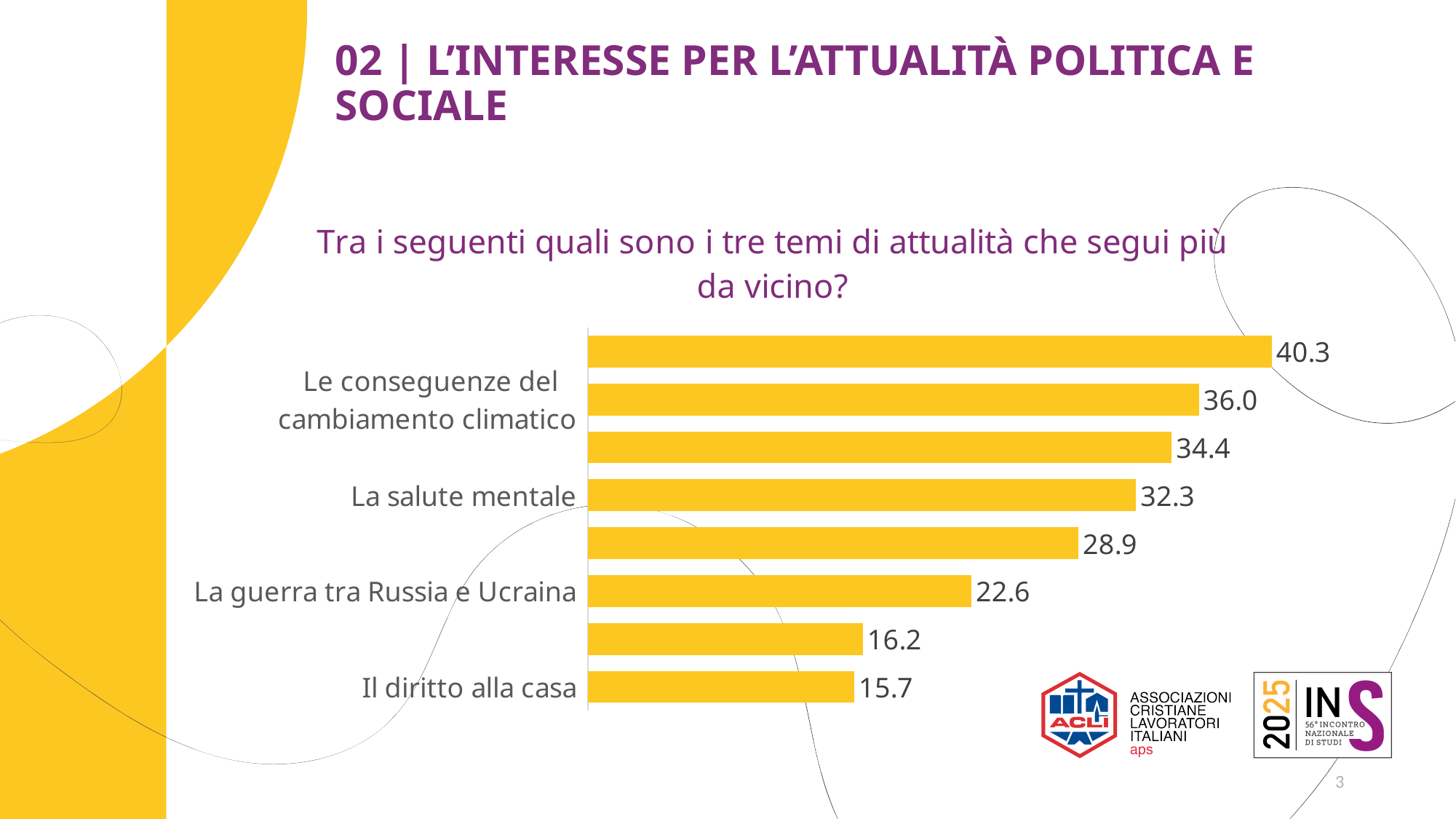
What is the difference between the values for "Le conseguenze del cambiamento climatico" and "Il diritto alla casa"? 20.3 What value is shown for "La guerra tra Russia e Ucraina"? 22.6 What is the difference between the values for "La salute mentale" and "La guerra tra Russia e Ucraina"? 9.7 What value is shown for "La salute mentale"? 32.3 What is the highest value shown on the chart? 40.3 What value is shown for "Il diritto alla casa"? 15.7 Which has a larger value, "La salute mentale" or "La guerra tra Russia e Ucraina"? La salute mentale What value is shown for "Le conseguenze del cambiamento climatico"? 36.0 Which labelled category has the lowest value on the chart? Il diritto alla casa Do the bar values increase or decrease going from the top bar to the bottom bar? Decrease How many bars are plotted on the chart? 8 What kind of chart is shown on the slide? Bar chart